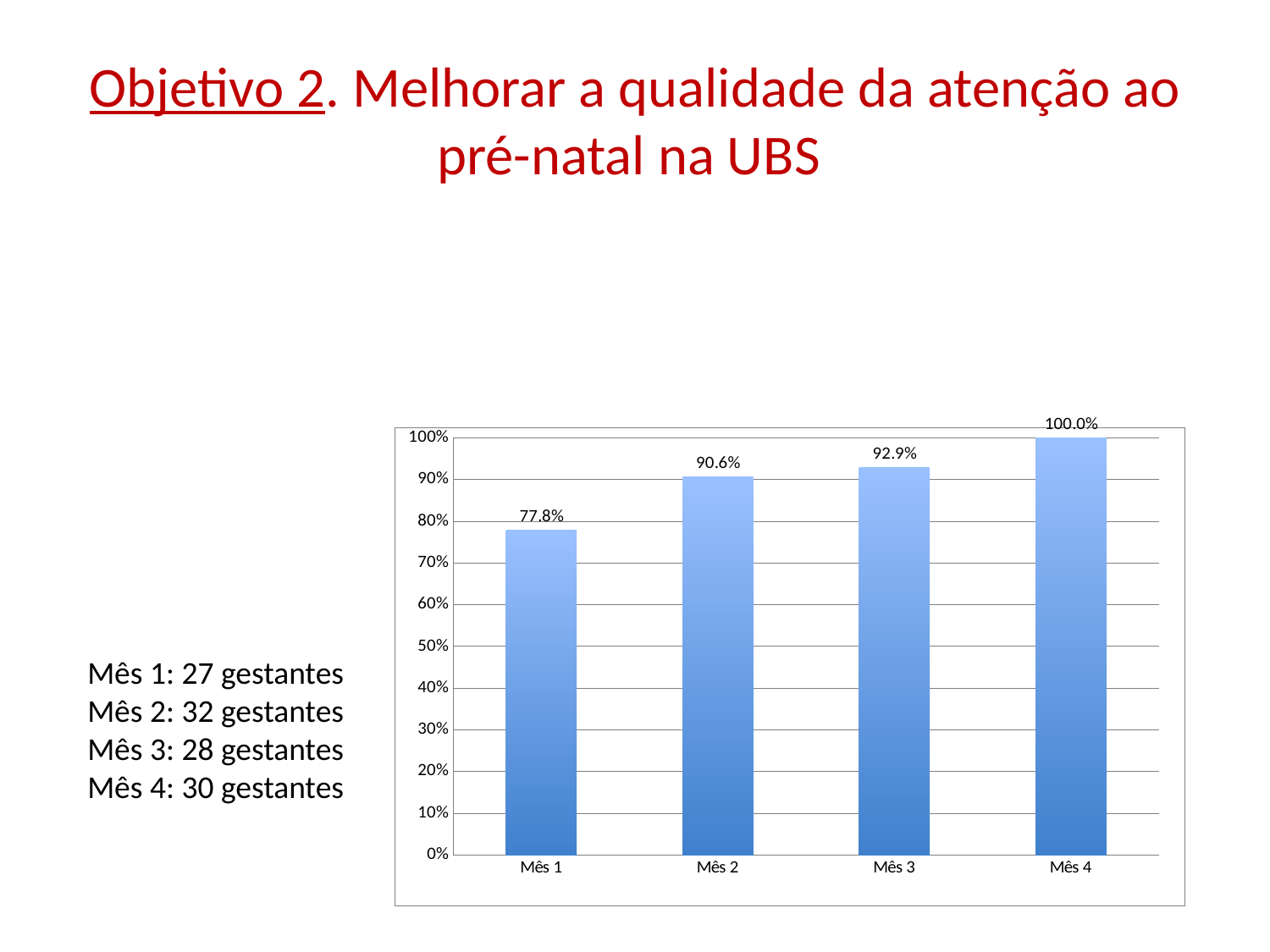
What is the value for Mês 1? 77.8% What is the value for Mês 4? 100.0% What is the value for Mês 3? 92.9% What is the difference between the values for Mês 4 and Mês 1? 22.2% What is the value for Mês 2? 90.6% Which is larger, the value for Mês 2 or Mês 3? Mês 3 Do the values rise or fall from Mês 1 to Mês 4? Rise What is the difference between the values for Mês 2 and Mês 1? 12.8% How many months are shown on the x axis of the chart? 4 Which month has the highest value? Mês 4 Which month has the lowest value? Mês 1 What kind of chart is shown on the slide? Bar chart